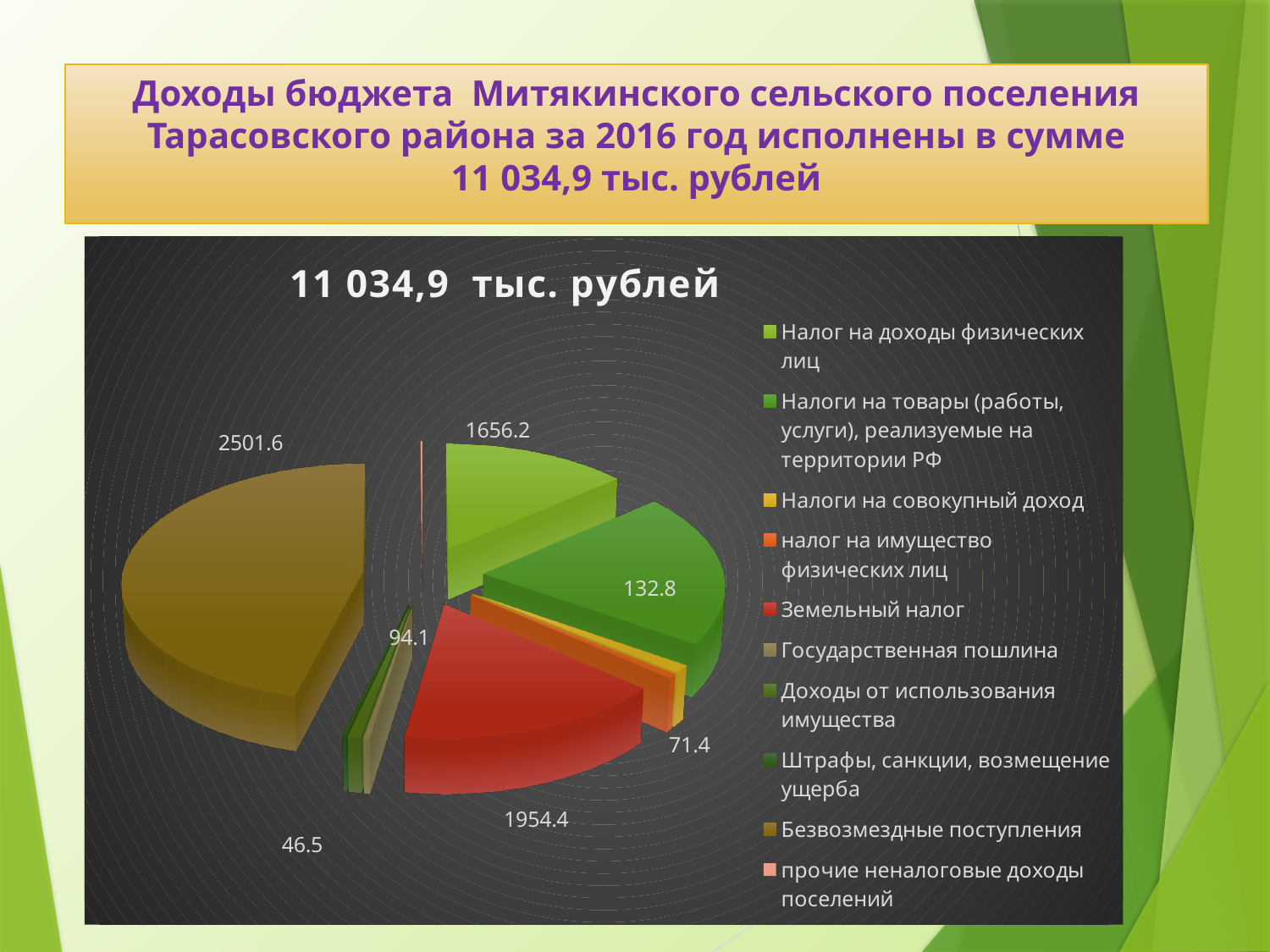
How many entries does the chart legend list? 10 What is the difference between the value for Земельный налог (1954.4) and the value for Налог на доходы физических лиц (1656.2)? 298.2 What value is labelled on the red slice (Земельный налог)? 1954.4 Which is larger, the value for Земельный налог or the value for Налог на доходы физических лиц? Земельный налог What value is labelled on the light green slice at the top (Налог на доходы физических лиц)? 1656.2 What is the first entry in the chart legend? Налог на доходы физических лиц What is the largest data label printed on the pie chart? 2501.6 What is the smallest data label printed on the pie chart? 46.5 What is the title of the chart? 11 034,9 тыс. рублей What total amount is stated in the slide title for the 2016 budget revenues? 11 034,9 тыс. рублей How many data labels are printed on the pie chart? 7 What kind of chart is shown on the slide? pie chart